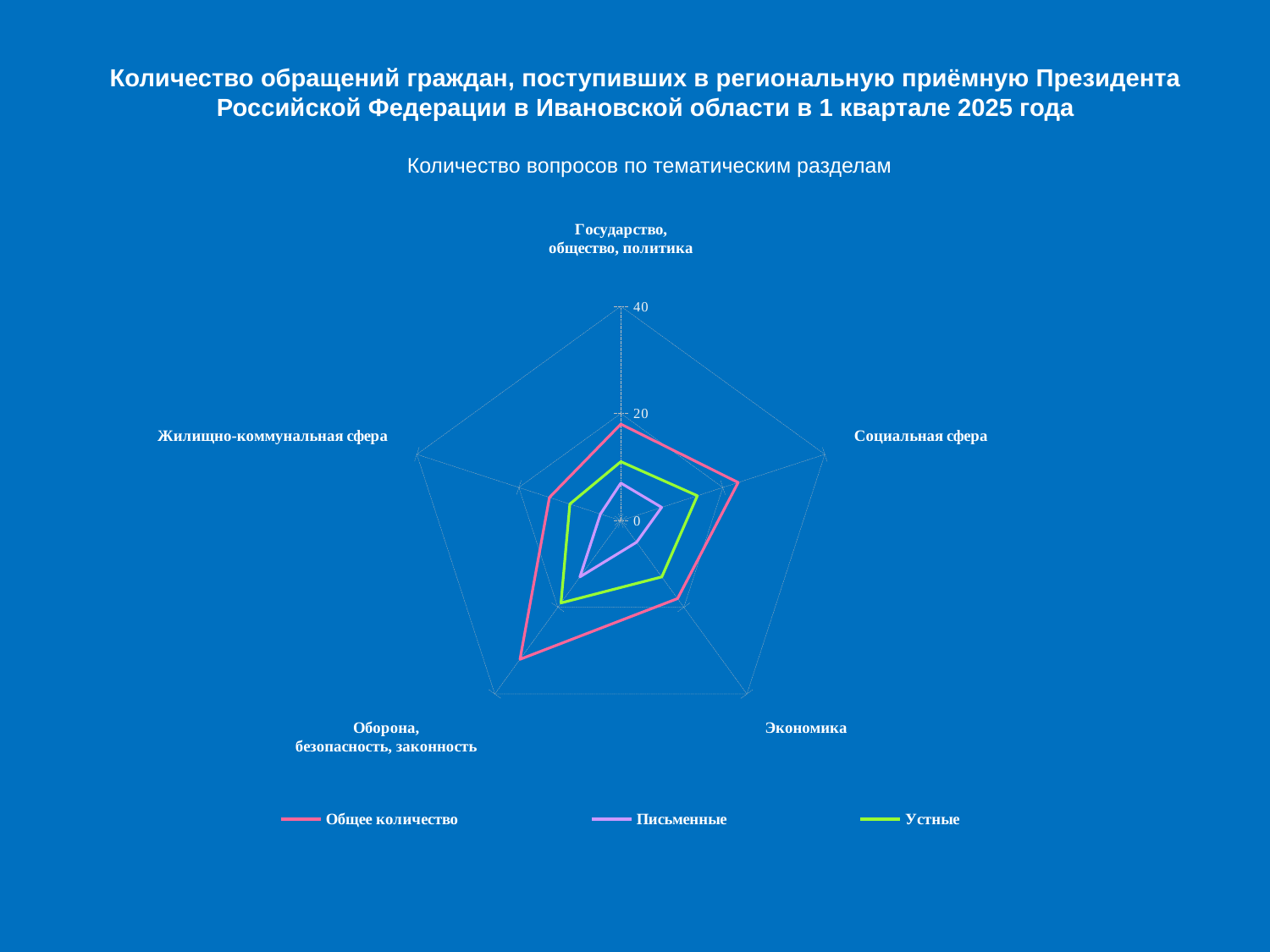
For the series "Устные", which is larger: the value for "Социальная сфера" or for "Жилищно-коммунальная сфера"? Социальная сфера How many thematic categories (axes) does the radar chart have? 5 For the series "Общее количество", which is larger: the value for "Оборона, безопасность, законность" or for "Социальная сфера"? Оборона, безопасность, законность What is the subtitle of the chart shown below the main title? Количество вопросов по тематическим разделам How many series does the legend list? 3 Is the value for "Жилищно-коммунальная сфера" in the series "Общее количество" greater or less than 20? less Which category has the highest value for the series "Общее количество"? Оборона, безопасность, законность What kind of chart is shown on the slide? Radar chart Is the value for "Государство, общество, политика" in the series "Устные" greater or less than 20? less Which category has the highest value for the series "Устные"? Оборона, безопасность, законность Which category has the lowest value for the series "Письменные"? Жилищно-коммунальная сфера Is the value for "Оборона, безопасность, законность" in the series "Общее количество" greater or less than 20? greater